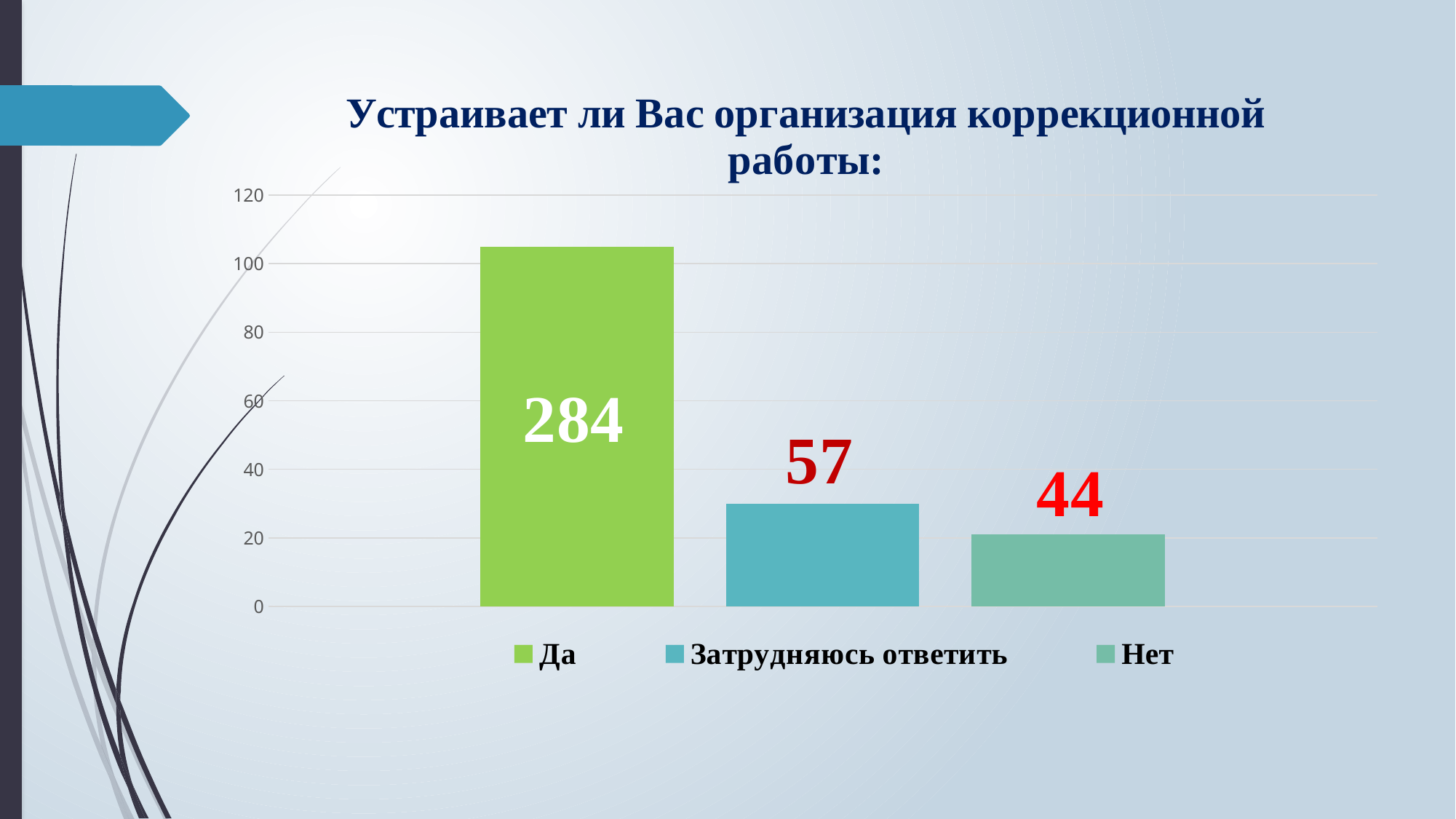
What value is shown for the category "Да"? 284 What value is shown for the category "Затрудняюсь ответить"? 57 What value is shown for the category "Нет"? 44 Which category has the highest value? Да What is the title of the chart? Устраивает ли Вас организация коррекционной работы: What kind of chart is shown on the slide? Bar chart How many entries does the legend list? 3 Which is larger, the value for "Затрудняюсь ответить" or the value for "Нет"? Затрудняюсь ответить What is the difference between the values for "Да" and "Нет"? 240 How many bars are plotted in the chart? 3 Which category has the lowest value? Нет What is the difference between the values for "Затрудняюсь ответить" and "Нет"? 13